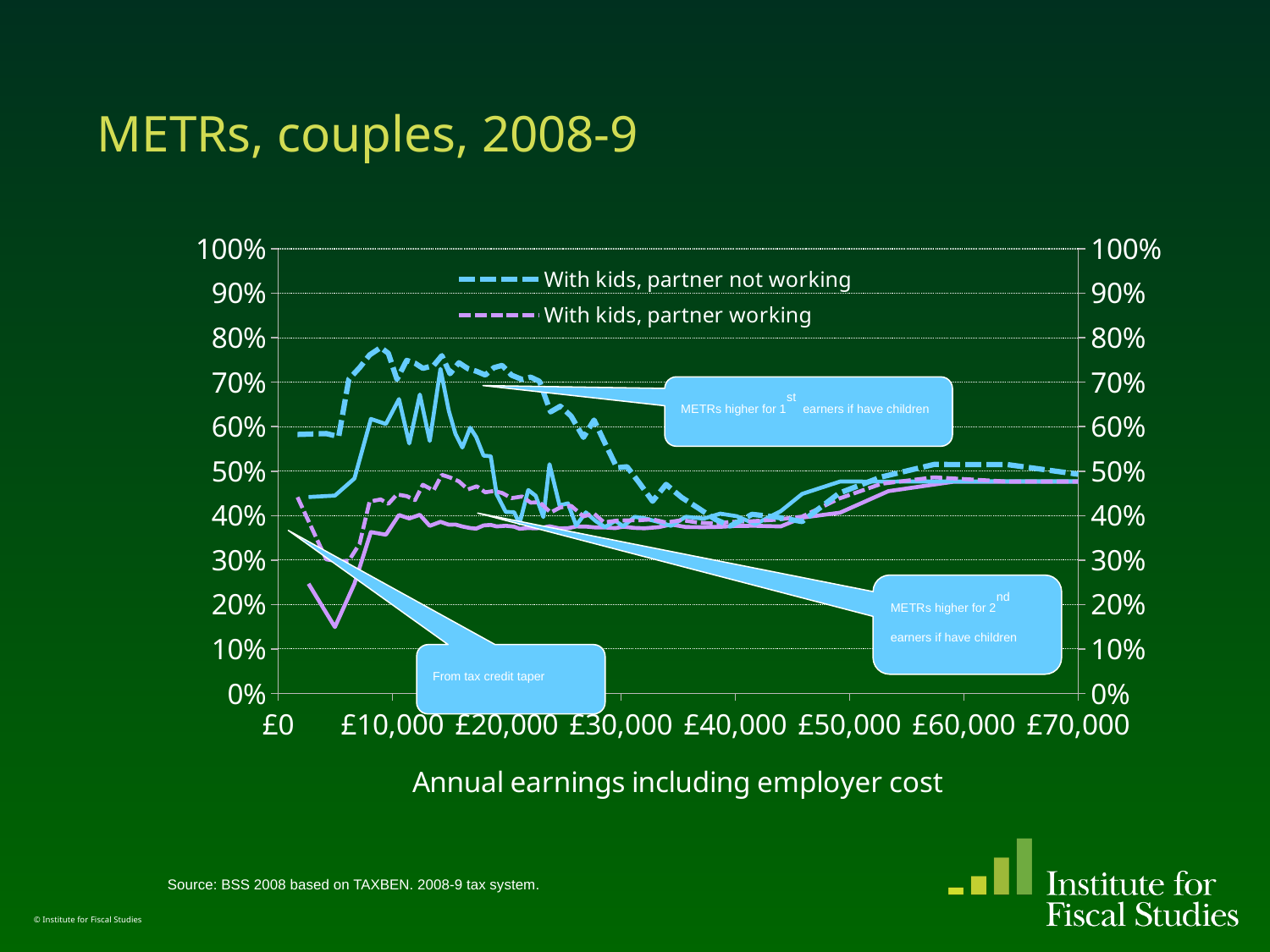
How many tick labels are shown on the x axis? 8 At £10,000 of annual earnings, which line is higher: 'With kids, partner not working' or 'With kids, partner working'? With kids, partner not working Is the value of the 'With kids, partner working' line at £40,000 greater or less than 50%? less What kind of chart is shown on the slide? Line chart How many series does the legend list? 2 Is the value of the 'With kids, partner not working' line at £10,000 greater or less than 60%? greater Does the 'With kids, partner working' line rise or fall between £40,000 and £60,000? Rise Is the value of the 'With kids, partner working' line at £20,000 greater or less than 40%? greater What is the title of the chart? METRs, couples, 2008-9 Does the 'With kids, partner not working' line rise or fall between £20,000 and £40,000? Fall What is the label of the x axis? Annual earnings including employer cost